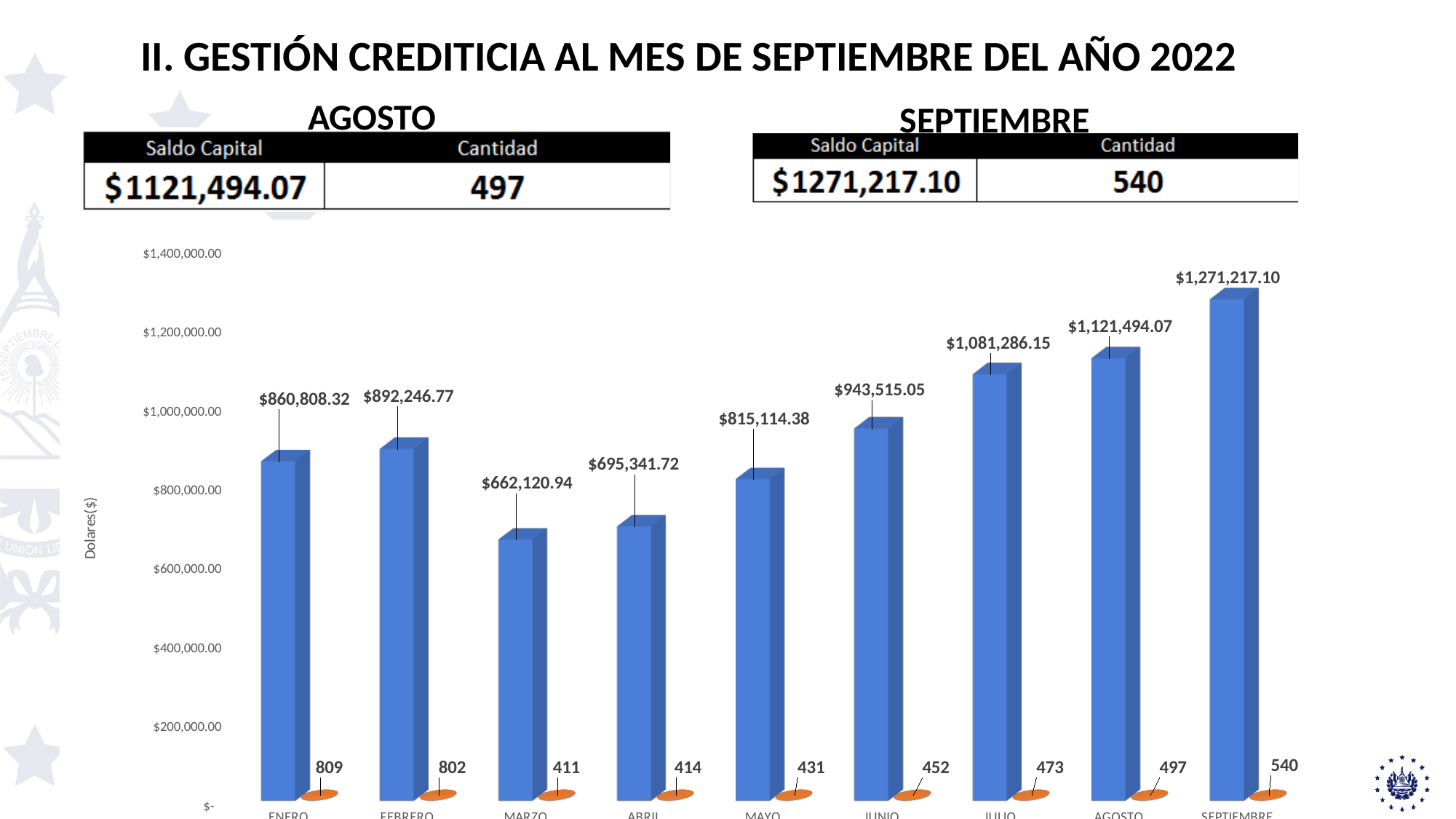
What is the Saldo Capital value shown for MARZO in the chart? $662,120.94 Do the Saldo Capital values rise or fall from MARZO to SEPTIEMBRE? rise Is the Saldo Capital value for JUNIO greater or less than $1,000,000.00? less What is the label on the vertical axis of the chart? Dolares($) Which month has the highest Saldo Capital bar in the chart? SEPTIEMBRE Which month has a larger Saldo Capital, FEBRERO or MAYO? FEBRERO What is the Cantidad value shown for ENERO in the chart? 809 What is the Saldo Capital value shown for SEPTIEMBRE in the chart? $1,271,217.10 How many months are shown on the x axis of the chart? 9 What is the difference between the Saldo Capital values for SEPTIEMBRE and AGOSTO? $149,723.03 Which month has the lowest Saldo Capital bar in the chart? MARZO What kind of chart is used to show the Saldo Capital values? bar chart